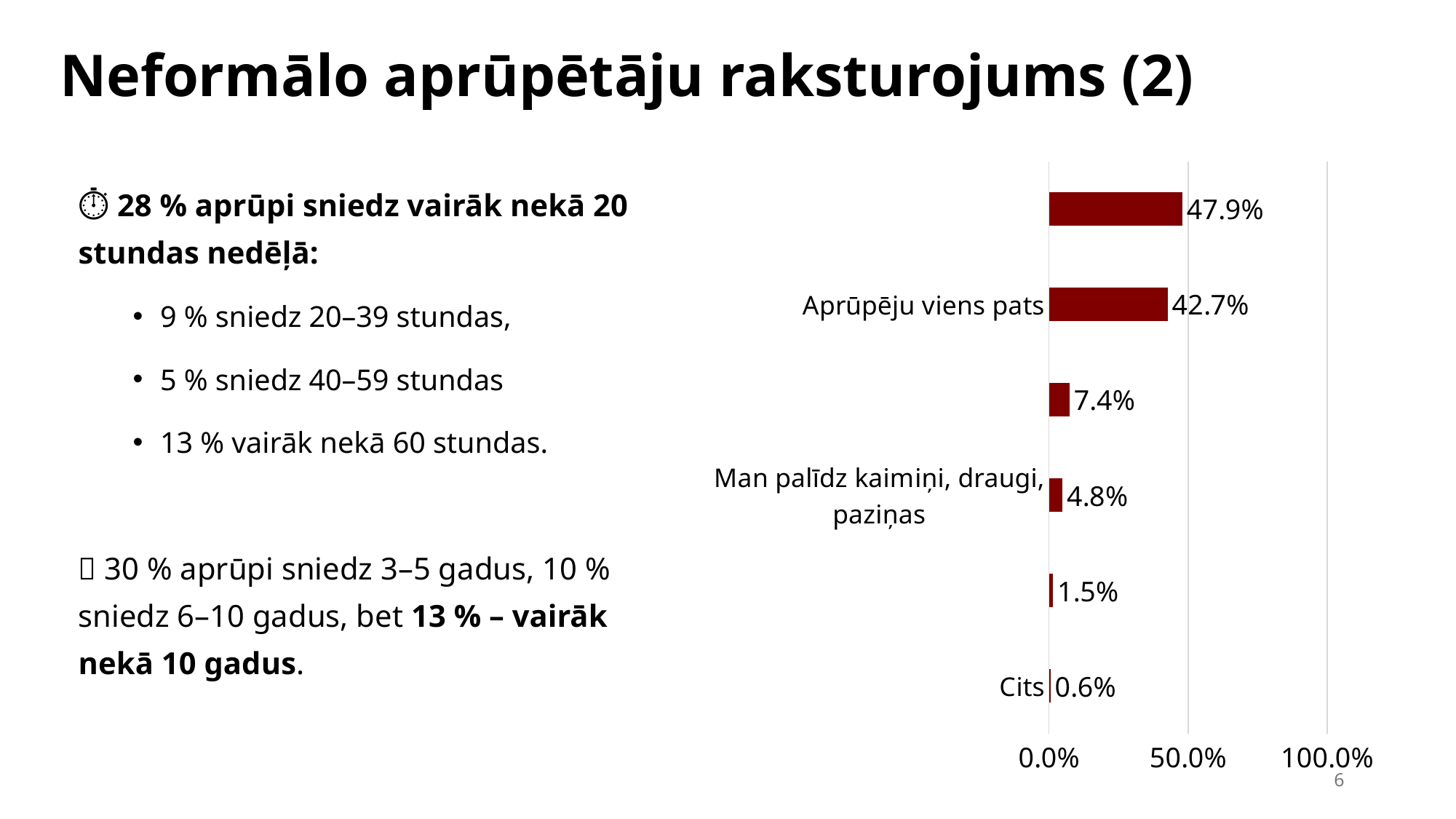
Is the value for "Aprūpēju viens pats" greater or less than 50.0%? less What kind of chart is shown on the slide? bar chart How many bars are shown in the chart? 6 What is the difference between the highest value in the chart and the value for "Aprūpēju viens pats"? 5.2 percentage points What is the highest value shown in the bar chart? 47.9% Which category has the lowest value in the bar chart? Cits What is the value for "Aprūpēju viens pats" in the bar chart? 42.7% Which is larger: the value for "Aprūpēju viens pats" or the value for "Cits"? Aprūpēju viens pats What is the difference between the values for "Aprūpēju viens pats" and "Man palīdz kaimiņi, draugi, paziņas"? 37.9 percentage points What is the value for "Man palīdz kaimiņi, draugi, paziņas" in the bar chart? 4.8% What colour are the bars in the chart? dark red What is the value for "Cits" in the bar chart? 0.6%